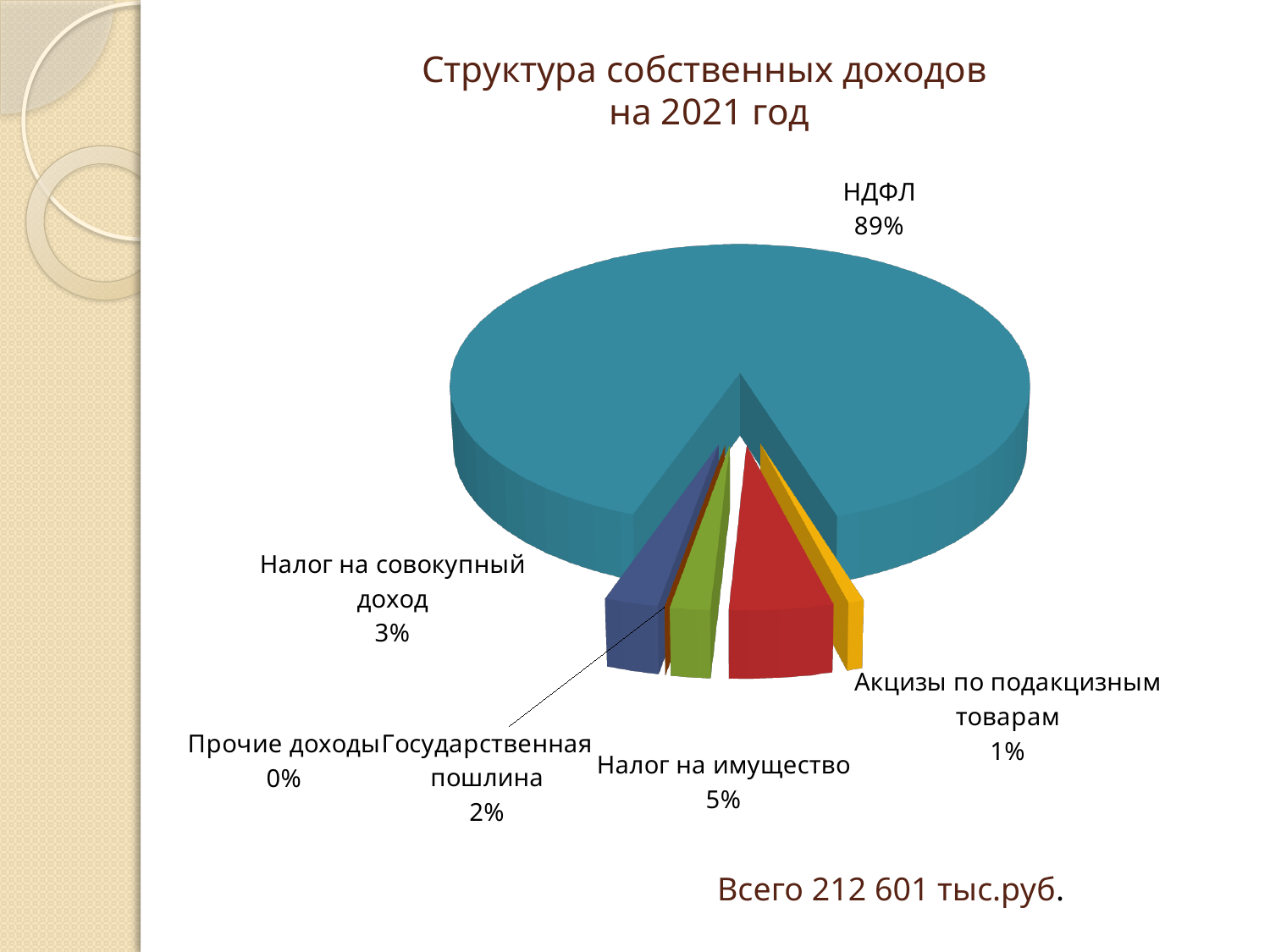
How many categories are shown in the pie chart? 6 What percentage is shown for Акцизы по подакцизным товарам? 1% What is the difference in percentage points between НДФЛ and Налог на имущество? 84 Which is larger, Налог на совокупный доход or Государственная пошлина? Налог на совокупный доход What share of the pie does НДФЛ account for? 89% What percentage is shown for Налог на совокупный доход? 3% Which category has the largest share of the pie? НДФЛ What type of chart is shown on the slide? Pie chart What percentage is shown for Прочие доходы? 0% What is the value shown for Налог на имущество? 5% Which category has the smallest share of the pie? Прочие доходы What percentage is shown for Государственная пошлина? 2%